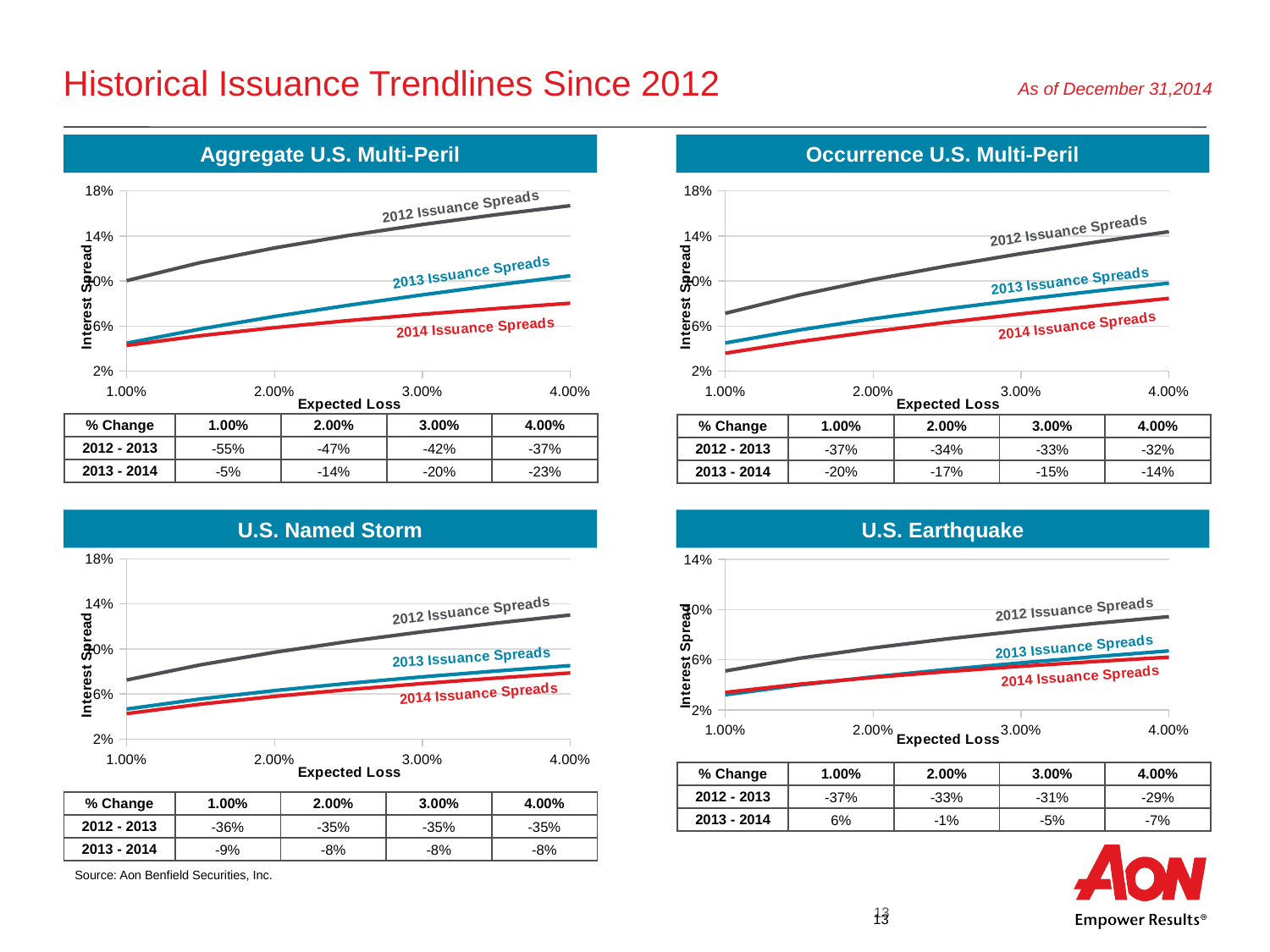
In the U.S. Earthquake chart, is the 2013 Issuance Spreads value at 1.00% Expected Loss greater or less than 6%? less What is the x-axis label on the Occurrence U.S. Multi-Peril chart? Expected Loss How many Expected Loss tick values are shown on the x axis of the U.S. Earthquake chart? 4 In the table below the Aggregate U.S. Multi-Peril chart, what is the 2012 - 2013 % Change at 1.00%? -55% In the Occurrence U.S. Multi-Peril chart, how many issuance spread series are plotted? 3 In the Aggregate U.S. Multi-Peril chart, is the 2012 Issuance Spreads value at 4.00% Expected Loss greater or less than 14%? greater In the Aggregate U.S. Multi-Peril chart, do the 2012 Issuance Spreads rise or fall as Expected Loss increases from 1.00% to 4.00%? rise What is the y-axis label on the U.S. Named Storm chart? Interest Spread In the Occurrence U.S. Multi-Peril chart, is the 2014 Issuance Spreads value at 1.00% Expected Loss greater or less than 6%? less In the Aggregate U.S. Multi-Peril chart, which series is lowest at 4.00% Expected Loss? 2014 Issuance Spreads In the U.S. Named Storm chart, which is larger at 4.00% Expected Loss: the 2012 Issuance Spreads or the 2014 Issuance Spreads? 2012 Issuance Spreads What kind of chart is the Aggregate U.S. Multi-Peril chart? line chart